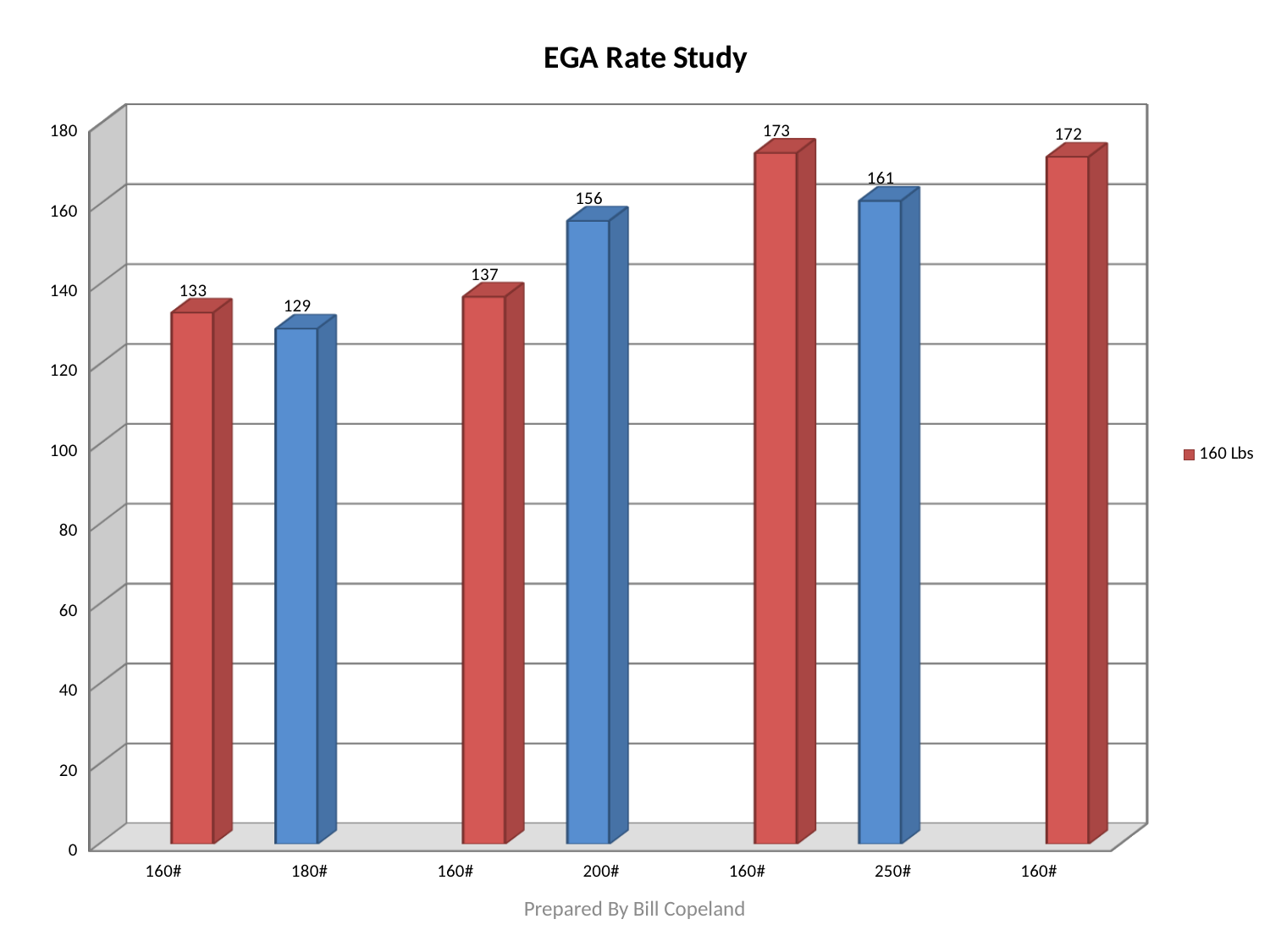
What is the title of the chart? EGA Rate Study What is the value for the 200# category? 156 What is the highest value shown on the chart? 173 Which has a larger value, 200# or 180#? 200# What is the value for the 250# category? 161 What is the value of the first bar from the left (labelled 160#)? 133 How many bars are plotted on the chart? 7 Which category has the lowest value? 180# What is the value for the 180# category? 129 What is the difference between the values for 250# and 200#? 5 What is the value of the fifth bar from the left (labelled 160#)? 173 What kind of chart is shown? Bar chart